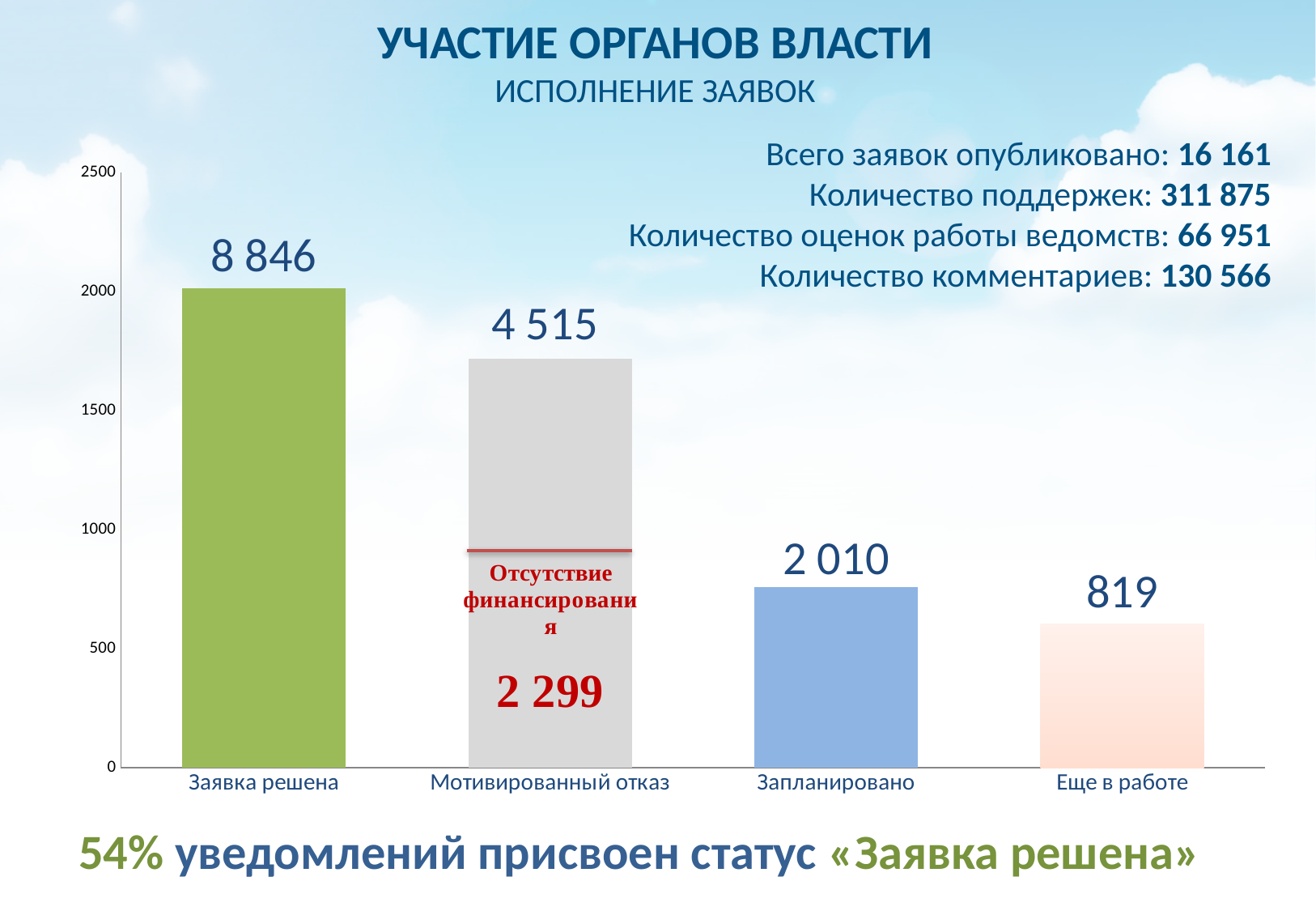
What kind of chart is shown on the slide? Bar chart What is the value for «Заявка решена»? 8 846 How many categories are shown on the x axis? 4 Which category has the lowest value? Еще в работе What is the difference between the values for «Заявка решена» and «Мотивированный отказ»? 4 331 What value is given for «Отсутствие финансирования» inside the «Мотивированный отказ» bar? 2 299 Which is larger, the value for «Запланировано» or the value for «Еще в работе»? Запланировано What is the subtitle of the chart shown under «УЧАСТИЕ ОРГАНОВ ВЛАСТИ»? ИСПОЛНЕНИЕ ЗАЯВОК What is the value for «Еще в работе»? 819 What is the value for «Мотивированный отказ»? 4 515 What is the value for «Запланировано»? 2 010 Which category has the highest value? Заявка решена